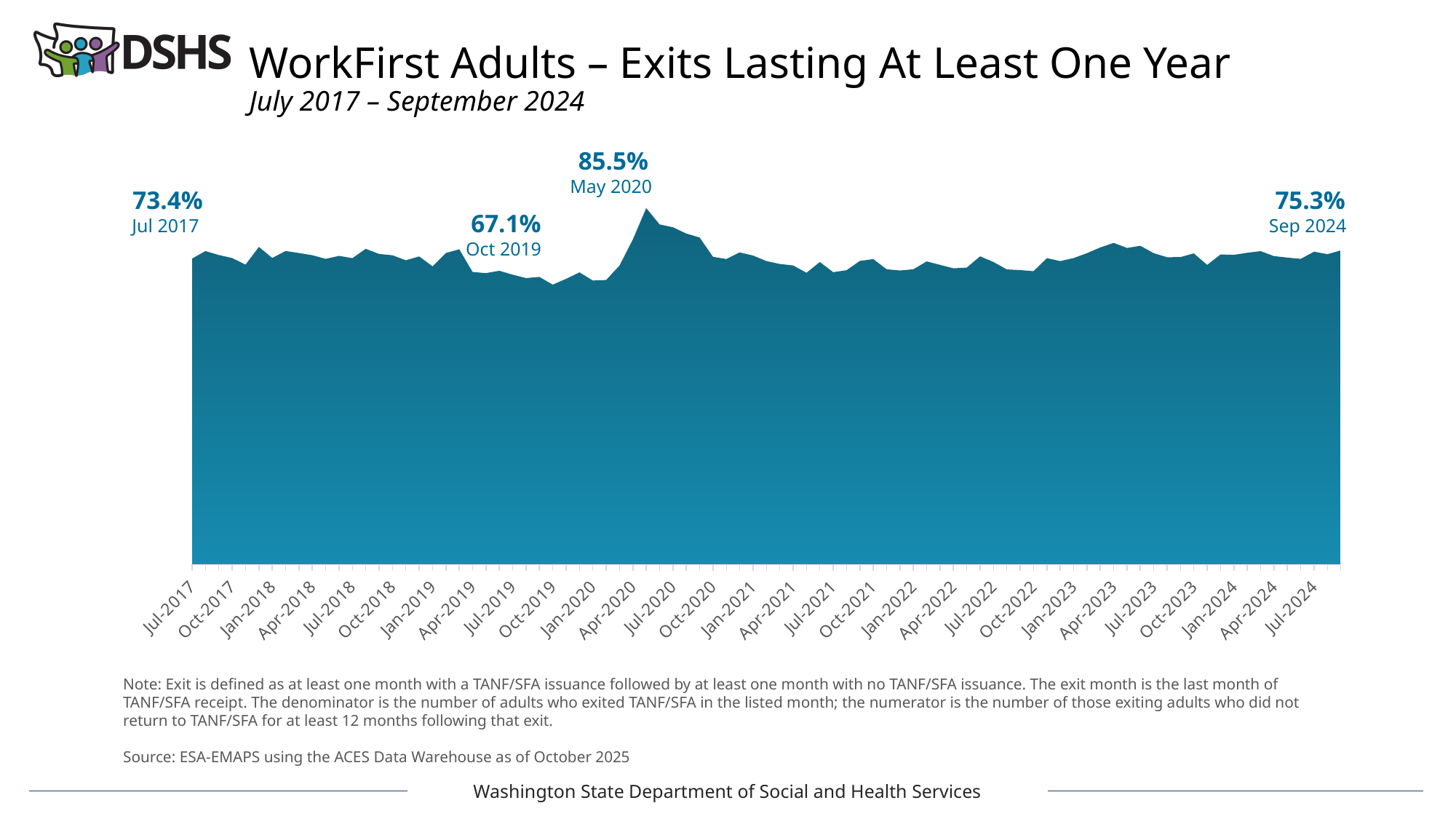
Which month has the lowest labeled value on the chart? Oct 2019 What was the value for Sep 2024? 75.3% Which month has the highest labeled value on the chart? May 2020 Which is larger, the value for Jul 2017 or the value for Sep 2024? Sep 2024 What kind of chart is shown on the slide? Area chart What is the difference between the May 2020 value and the Oct 2019 value? 18.4 percentage points What is the difference between the Sep 2024 value and the Jul 2017 value? 1.9 percentage points What is the title of the chart? WorkFirst Adults – Exits Lasting At Least One Year What was the value for Oct 2019? 67.1% What was the value for Jul 2017? 73.4% Between Oct 2019 and May 2020, do the values rise or fall? Rise What was the value for May 2020? 85.5%